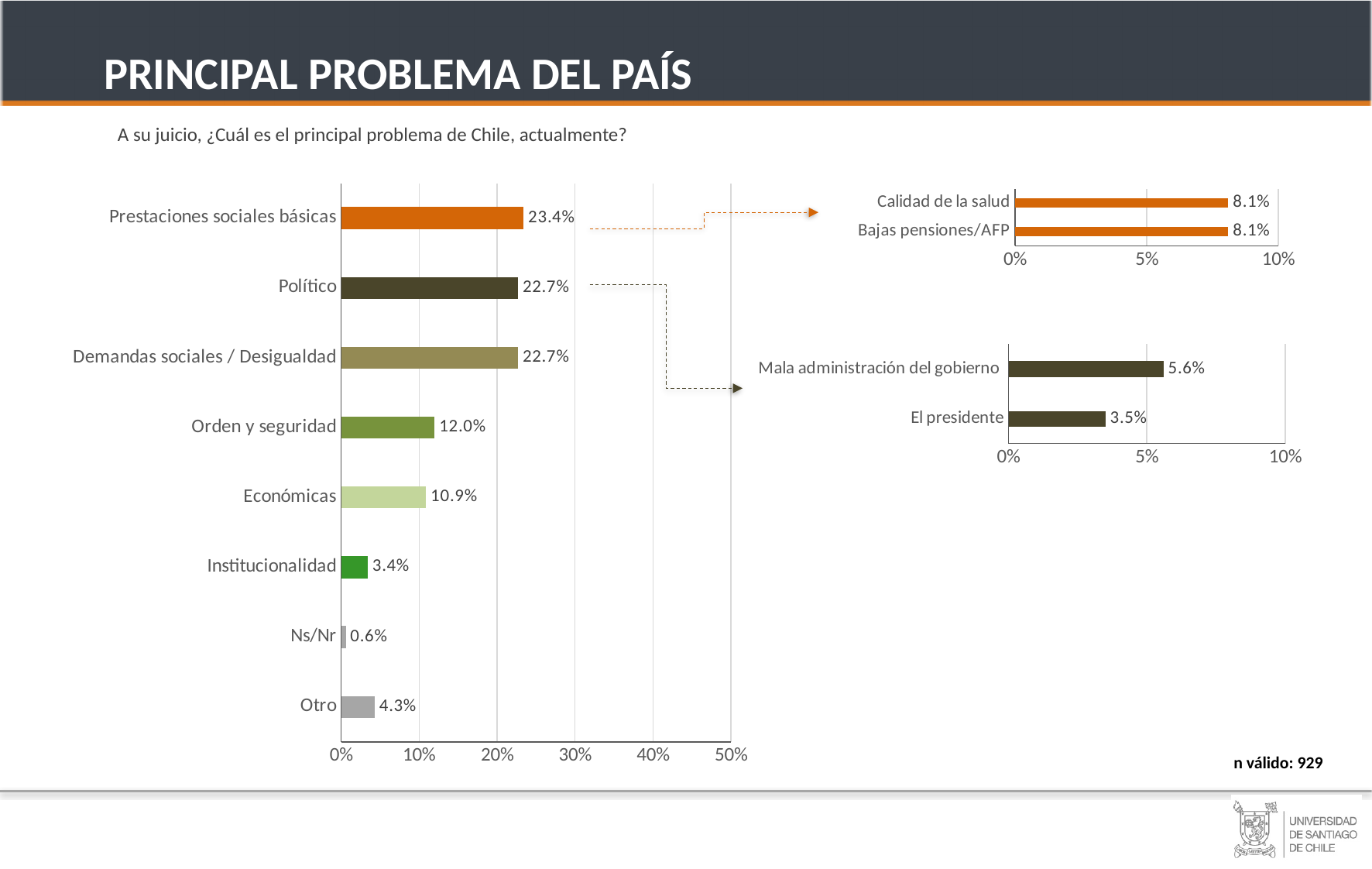
In the main chart on the left, which is larger: Institucionalidad or Otro? Otro In the top-right chart, what is the value for Calidad de la salud? 8.1% What kind of chart is the main chart on the left? Bar chart In the main chart on the left, which category has the highest value? Prestaciones sociales básicas How many categories are shown in the main chart on the left? 8 What is the valid sample size (n válido) shown on the slide? 929 In the main chart on the left, what is the value for Orden y seguridad? 12.0% In the middle-right chart, what is the value for Mala administración del gobierno? 5.6% In the main chart on the left, what is the value for Prestaciones sociales básicas? 23.4% In the middle-right chart, what is the difference between Mala administración del gobierno and El presidente? 2.1% In the main chart on the left, which category has the lowest value? Ns/Nr In the main chart on the left, what is the difference between Orden y seguridad and Económicas? 1.1%